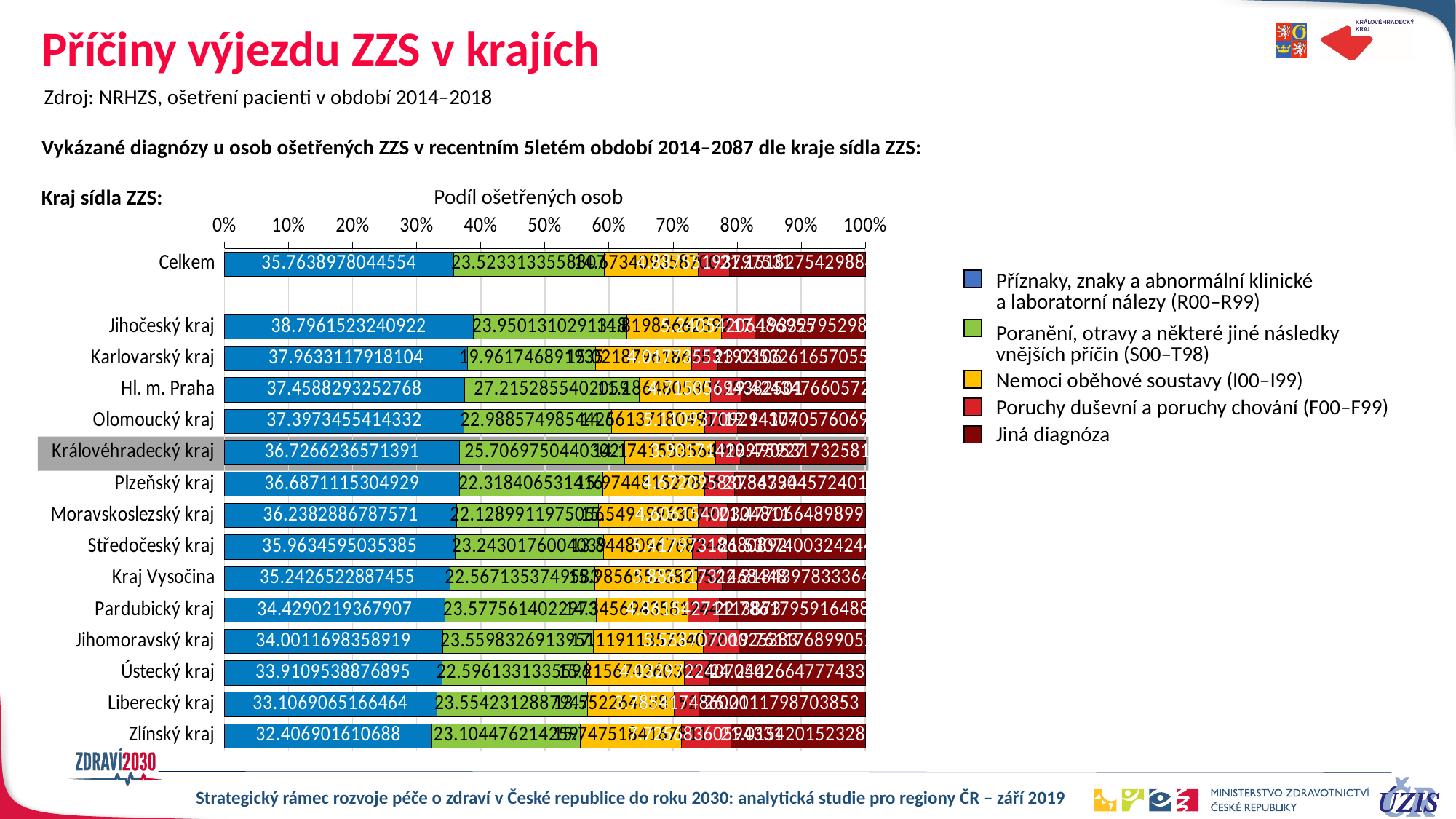
What is the difference between the blue segment values of Jihočeský kraj and Zlínský kraj? 6.3892507134042 What is the value of the blue segment (Příznaky, znaky a abnormální klinické a laboratorní nálezy) for Celkem? 35.7638978044554 How many series does the legend list? 5 How many regions (kraje) are plotted below the 'Celkem' bar? 14 Which diagnosis group is shown in dark red in the legend? Jiná diagnóza Which region has the lowest value for the blue segment (R00–R99)? Zlínský kraj Which region has the highest value for the blue segment (R00–R99)? Jihočeský kraj What type of chart is shown on the slide? stacked bar chart What is the value of the blue segment for Královéhradecký kraj? 36.7266236571391 Is the blue segment value for Jihočeský kraj greater or less than 40%? less What is the value of the blue segment for Zlínský kraj? 32.406901610688 Which has a larger blue segment value, Hl. m. Praha or Liberecký kraj? Hl. m. Praha